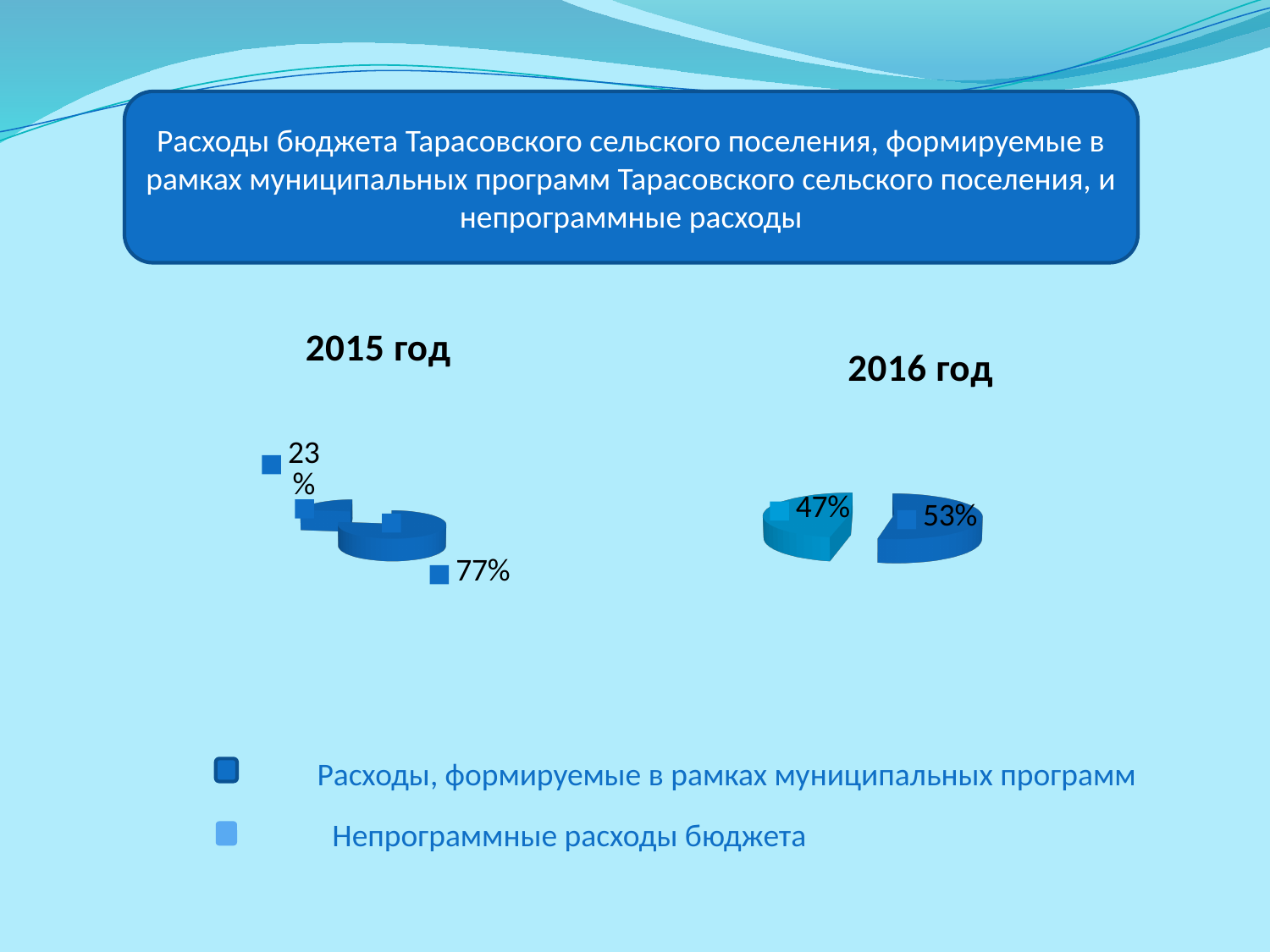
In the "2016 год" chart, what share is shown for the dark blue slice (Расходы, формируемые в рамках муниципальных программ)? 53% In the "2015 год" chart, what share is labelled for the smaller slice? 23% Which chart has the larger share for Расходы, формируемые в рамках муниципальных программ: "2015 год" or "2016 год"? 2015 год In the "2016 год" chart, what is the difference between the two slices' shares? 6 percentage points In the "2015 год" chart, what is the difference between the two slices' shares? 54 percentage points In the "2016 год" chart, which slice is larger: 47% or 53%? 53% In the "2016 год" chart, what share is shown for the light blue slice (Непрограммные расходы бюджета)? 47% According to the legend, which category does the dark blue colour represent? Расходы, формируемые в рамках муниципальных программ In the "2015 год" chart, what share is labelled for the larger slice? 77% How many slices does the "2016 год" chart have? 2 How many entries does the legend at the bottom of the slide list? 2 What kind of chart is used for "2015 год"? Pie chart